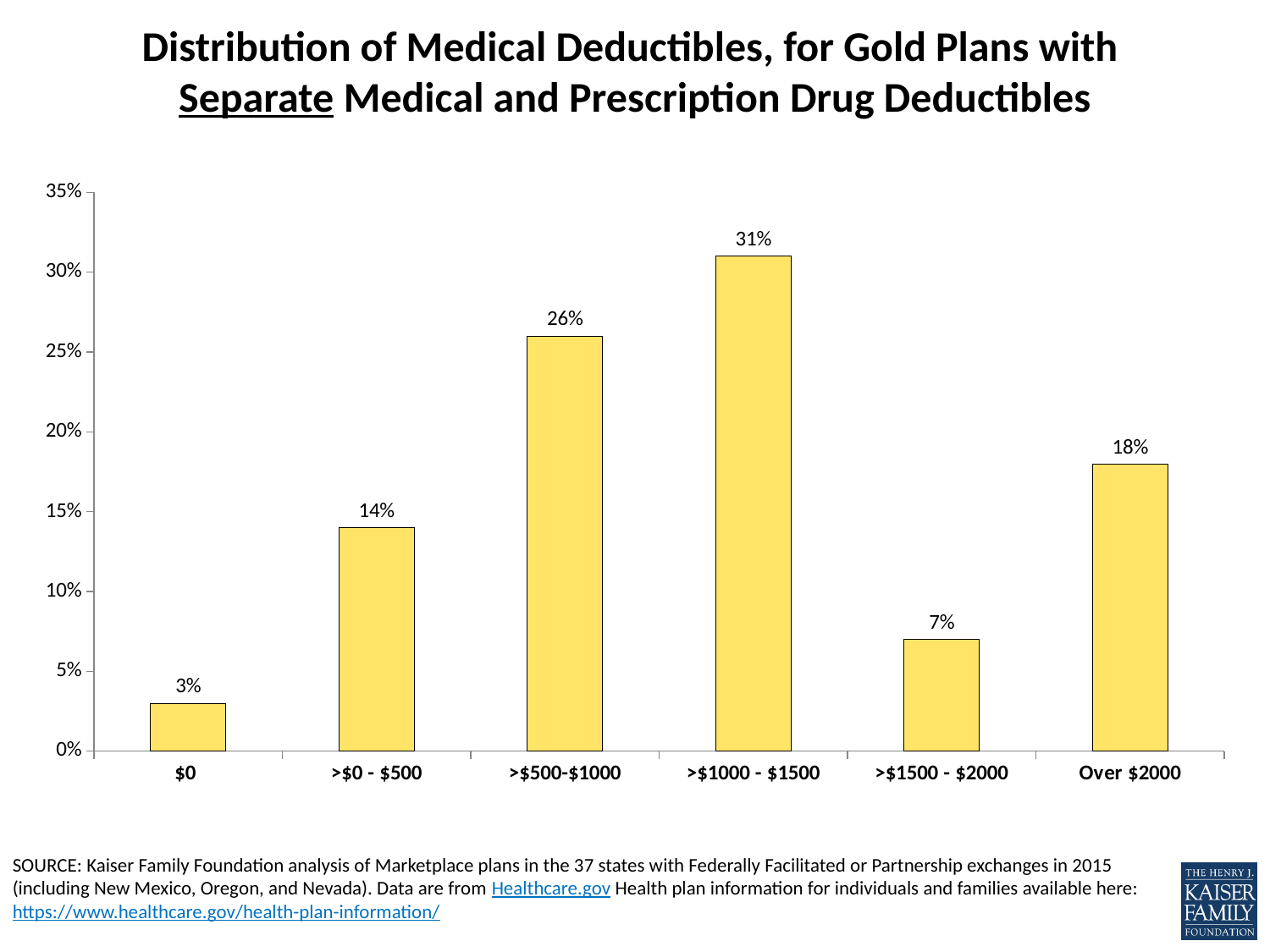
What is the difference between the >$500-$1000 and >$0 - $500 categories? 12% What is the value for the >$1500 - $2000 category? 7% Which deductible category has the highest share of plans? >$1000 - $1500 What percentage of gold plans with separate deductibles have a medical deductible of $0? 3% What is the maximum value shown on the y axis? 35% What kind of chart is shown on the slide? Bar chart What is the value for the >$1000 - $1500 category? 31% Which is larger, the value for Over $2000 or the value for >$0 - $500? Over $2000 What is the value for the Over $2000 category? 18% How many deductible categories are shown on the x axis? 6 Is the value for >$500-$1000 greater or less than 25%? greater Which deductible category has the lowest share of plans? $0